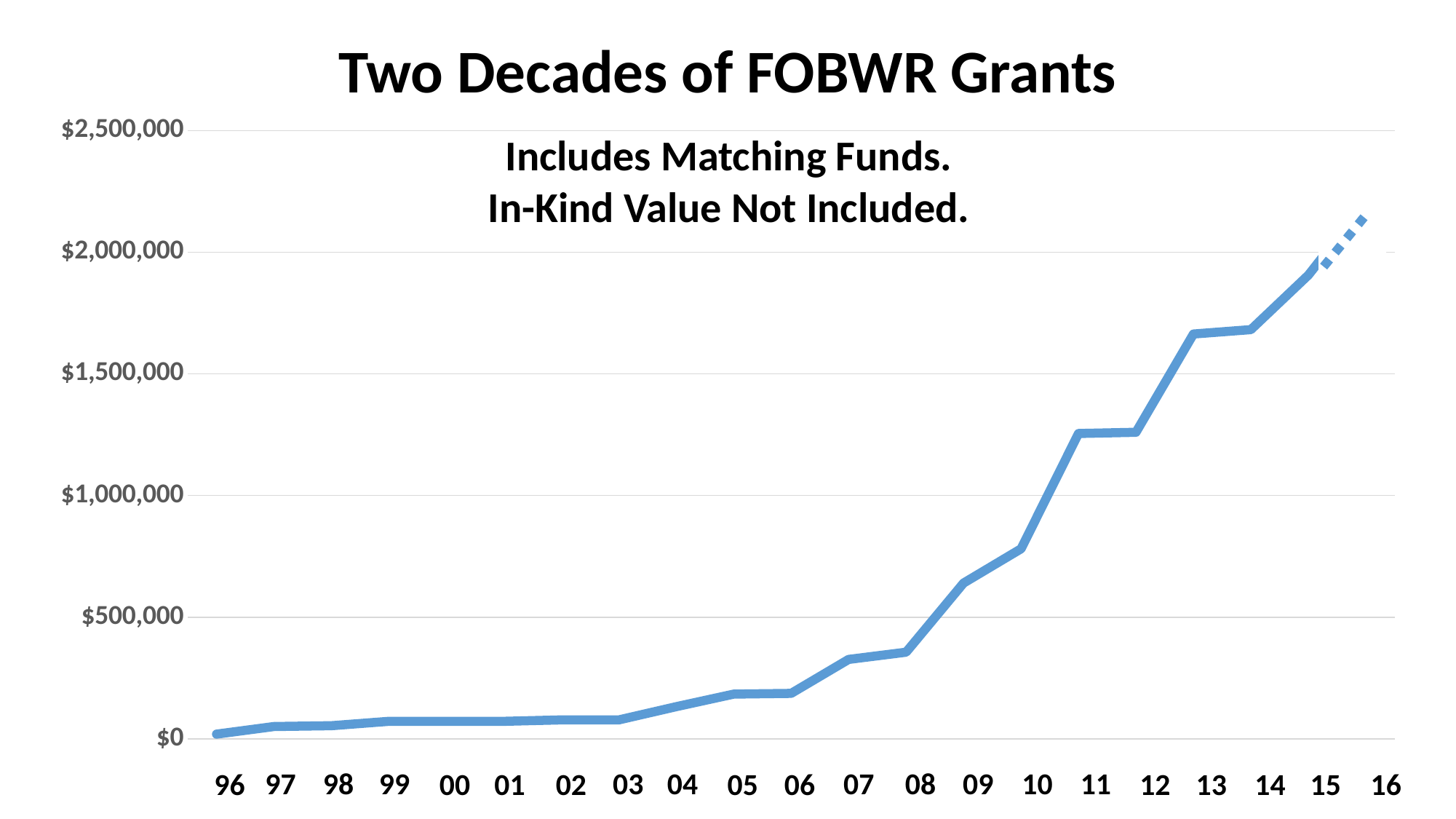
Is the value for 11 greater or less than $1,000,000? greater Which year has the lowest value on the chart? 96 How many years are labelled along the x axis of the chart? 21 Which year has the highest value on the chart? 16 What is the title of the chart? Two Decades of FOBWR Grants According to the subtitle, what does the chart include? Matching Funds What kind of chart is shown on the slide? line chart Is the value for 08 greater or less than $500,000? less Which year has the larger value, 13 or 10? 13 Is the value for 10 greater or less than $1,000,000? less Do the values generally rise or fall from 96 to 16? rise